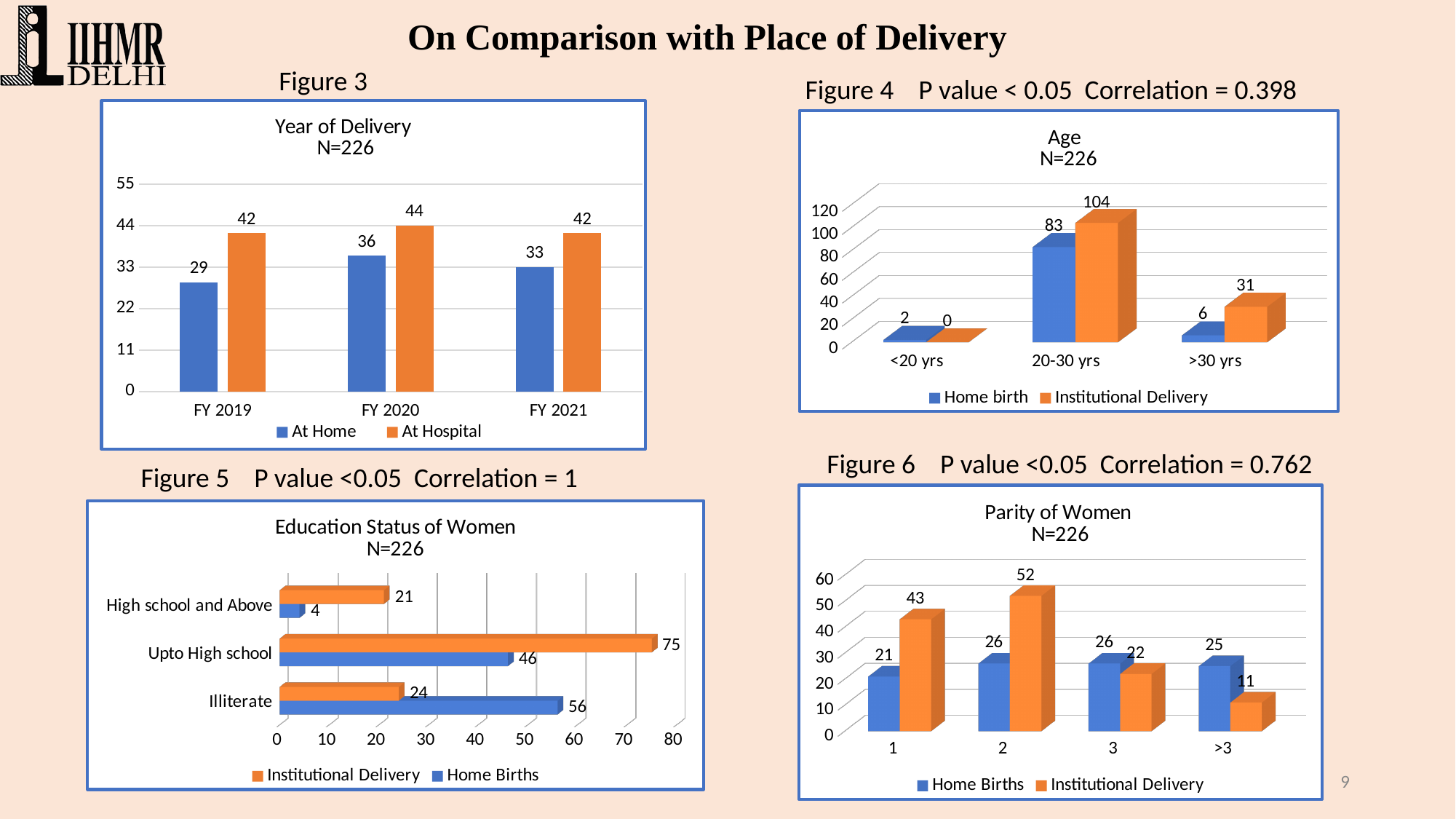
In the 'Age' chart, what is the Institutional Delivery value for 20-30 yrs? 104 What type of chart is the 'Education Status of Women' chart? Bar chart In the 'Age' chart, how many age categories are shown on the x axis? 3 In the 'Education Status of Women' chart, what is the total of Institutional Delivery and Home Births for Upto High school? 121 In the 'Parity of Women' chart, which parity category has the highest Institutional Delivery value? 2 In the 'Year of Delivery' chart, what is the difference between At Hospital and At Home in FY 2021? 9 In the 'Education Status of Women' chart, what is the Home Births value for Illiterate? 56 In the 'Education Status of Women' chart, which education category has the highest Institutional Delivery value? Upto High school In the 'Age' chart, what is the Home birth value for >30 yrs? 6 In the 'Year of Delivery' chart, which fiscal year has the lowest At Home value? FY 2019 In the 'Year of Delivery' chart, what is the value for At Hospital in FY 2020? 44 In the 'Parity of Women' chart, which is larger for parity >3: Home Births or Institutional Delivery? Home Births